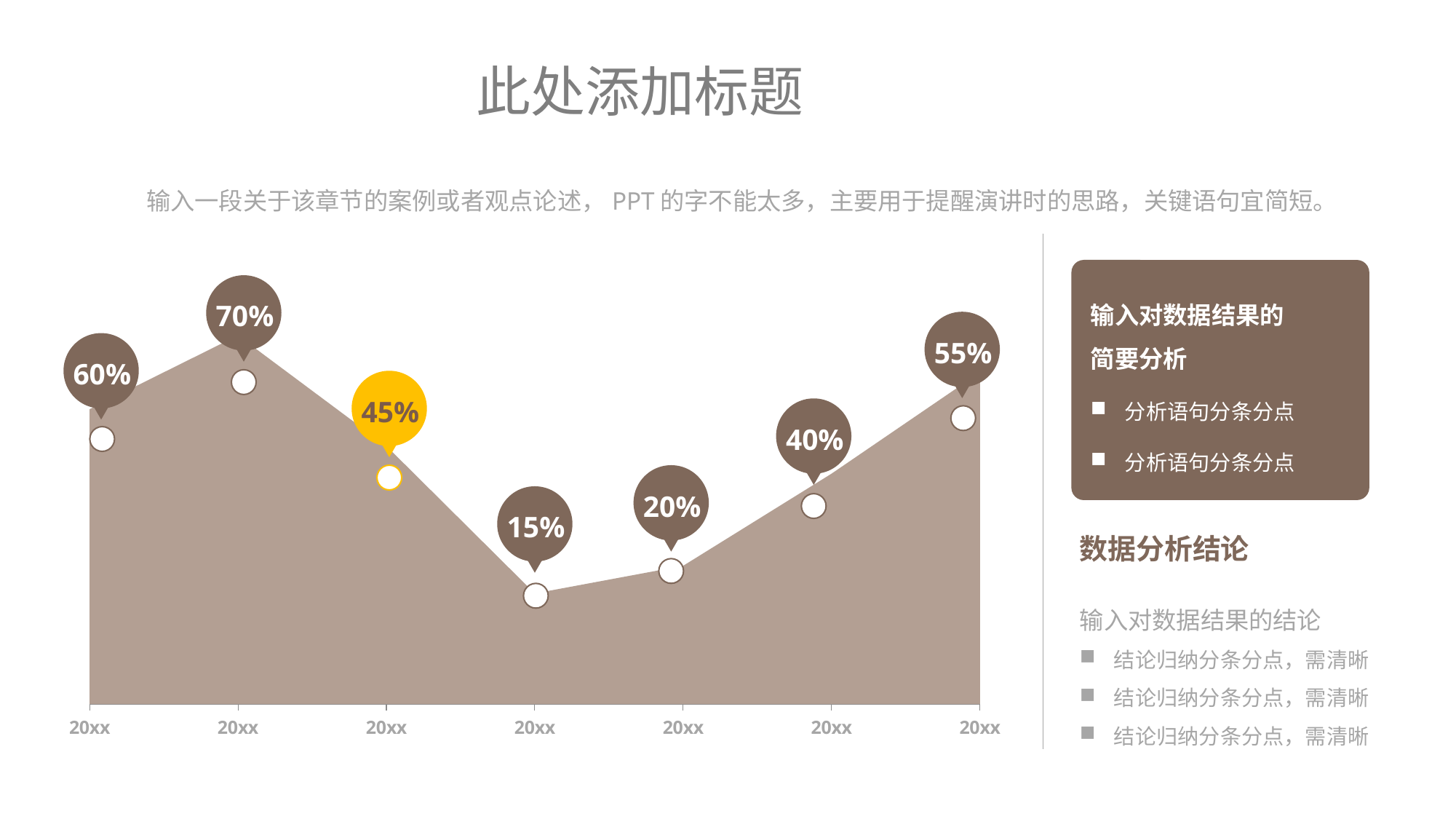
Which is larger, the first data point (60%) or the last data point (55%)? the first data point, 60% What kind of chart is shown on the slide? area chart What is the value of the first (leftmost) data point on the chart? 60% What is the value of the data point highlighted in yellow? 45% What is the value of the second data point from the left on the chart? 70% What is the lowest value shown on the chart? 15% What is the difference between the highest value (70%) and the lowest value (15%) on the chart? 55% Which data point has the highest value on the chart? the second point, 70% What is the value of the last (rightmost) data point on the chart? 55% Do the values rise or fall between the fourth and the seventh data points on the chart? rise How many data points are plotted on the chart? 7 What label is used for every category on the x axis of the chart? 20xx